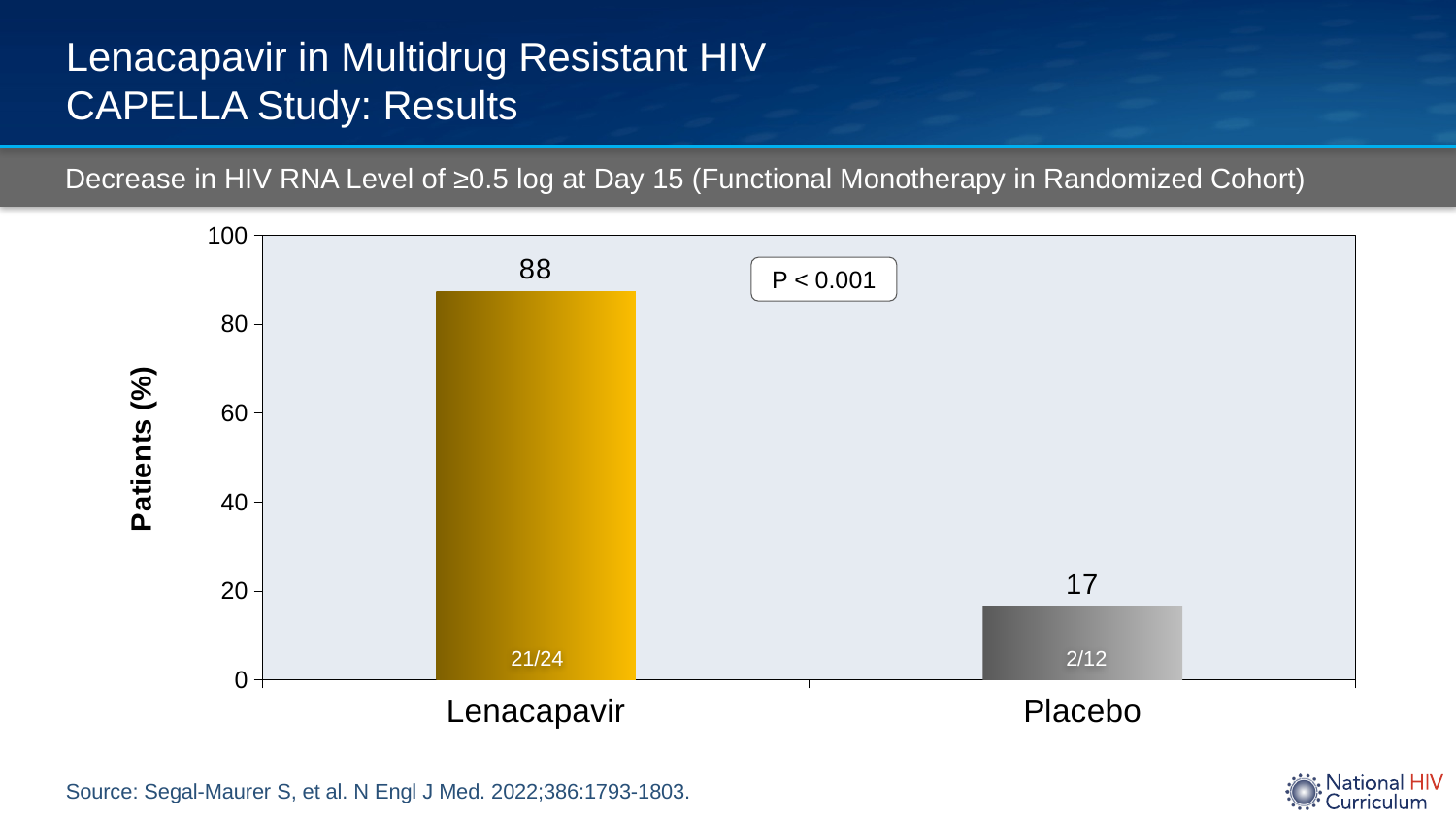
What fraction of patients is printed inside the Placebo bar? 2/12 What is the value for Lenacapavir? 88 How many categories are shown on the x axis? 2 Which category has the highest value? Lenacapavir Is the value for Placebo greater or less than 20? less What kind of chart is shown? bar chart Which category has the lowest value? Placebo What fraction of patients is printed inside the Lenacapavir bar? 21/24 What is the y-axis label of the chart? Patients (%) What is the difference between the Lenacapavir and Placebo values? 71 Which is larger, the value for Lenacapavir or the value for Placebo? Lenacapavir What is the value for Placebo? 17